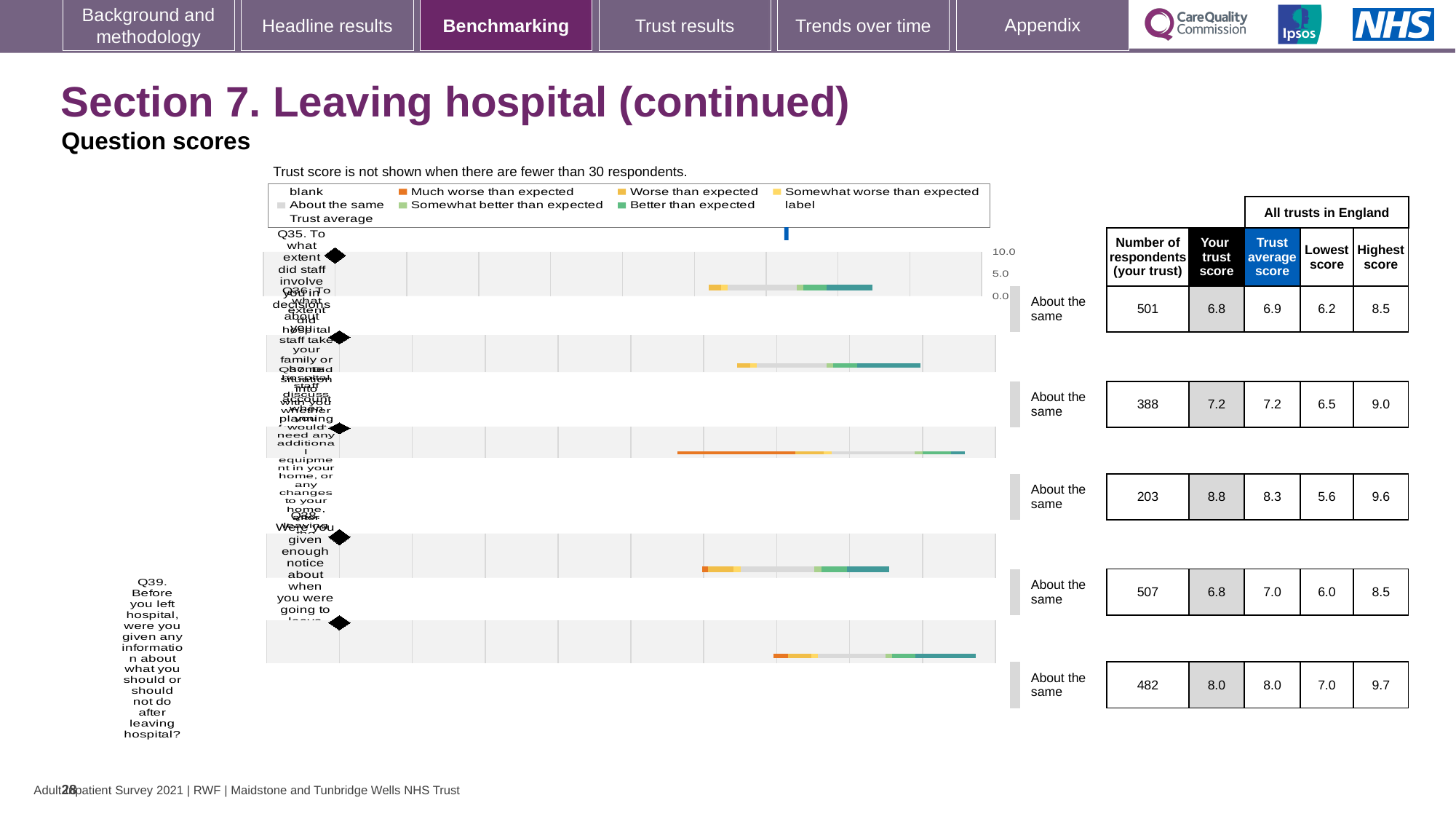
What colour represents 'Much worse than expected' in the legend? Orange What is the lowest score across all trusts in England for Q38 (given enough notice about when you were going to leave)? 6.0 What is the trust average score for Q35 (staff involving you in decisions about leaving hospital)? 6.9 How many questions are benchmarked on this slide? 5 What is the highest score across all trusts in England for Q36 (staff taking your family or home situation into account)? 9.0 What is the number of respondents for Q39 (information about what you should or should not do after leaving hospital)? 482 What benchmark category is shown for every question on this slide? About the same What is the trust score for Q39 (information about what you should or should not do after leaving hospital)? 8.0 What is the difference between the trust score and the trust average score for Q37? 0.5 Is the trust score for Q38 higher or lower than the trust average score for Q38? lower Which question has the fewest respondents in the table? Q37 (203) Which question has the highest 'Your trust score' in the table? Q37 (8.8)